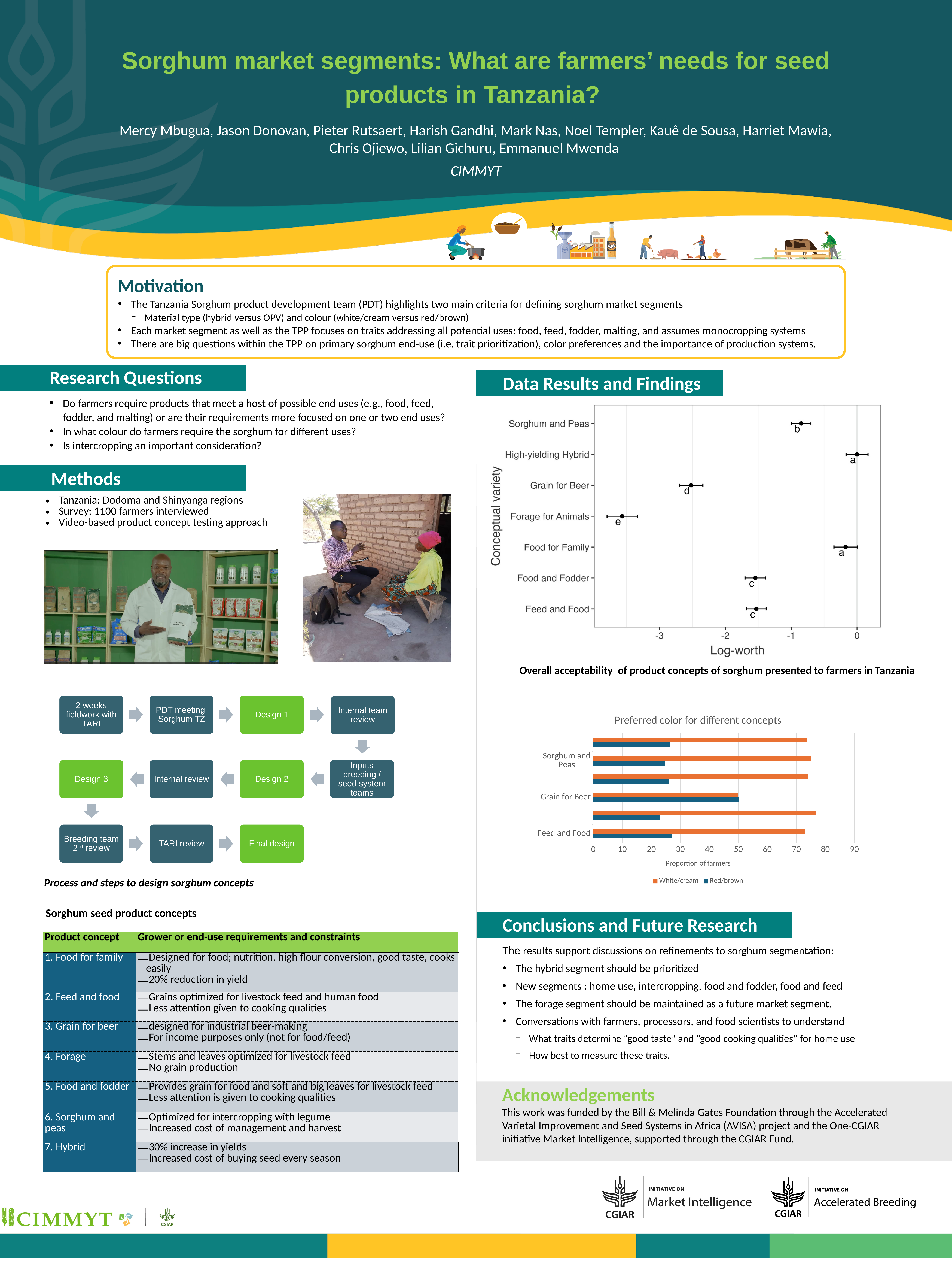
In the top chart (Overall acceptability of product concepts), is the log-worth for Grain for Beer greater or less than -2? less In the bottom chart 'Preferred color for different concepts', which series is larger for Feed and Food, White/cream or Red/brown? White/cream In the bottom chart 'Preferred color for different concepts', is the White/cream value for Sorghum and Peas greater or less than 60? greater In the bottom chart 'Preferred color for different concepts', is the Red/brown value for Feed and Food greater or less than 40? less What kind of chart is the bottom chart titled 'Preferred color for different concepts'? bar chart In the top chart (Overall acceptability of product concepts), which has the higher log-worth, Sorghum and Peas or Grain for Beer? Sorghum and Peas In the top chart (Overall acceptability of product concepts), which conceptual variety has the lowest log-worth? Forage for Animals In the top chart (Overall acceptability of product concepts), what is the x-axis label? Log-worth In the bottom chart 'Preferred color for different concepts', how many series does the legend list? 2 In the top chart (Overall acceptability of product concepts), how many conceptual varieties are plotted on the y axis? 7